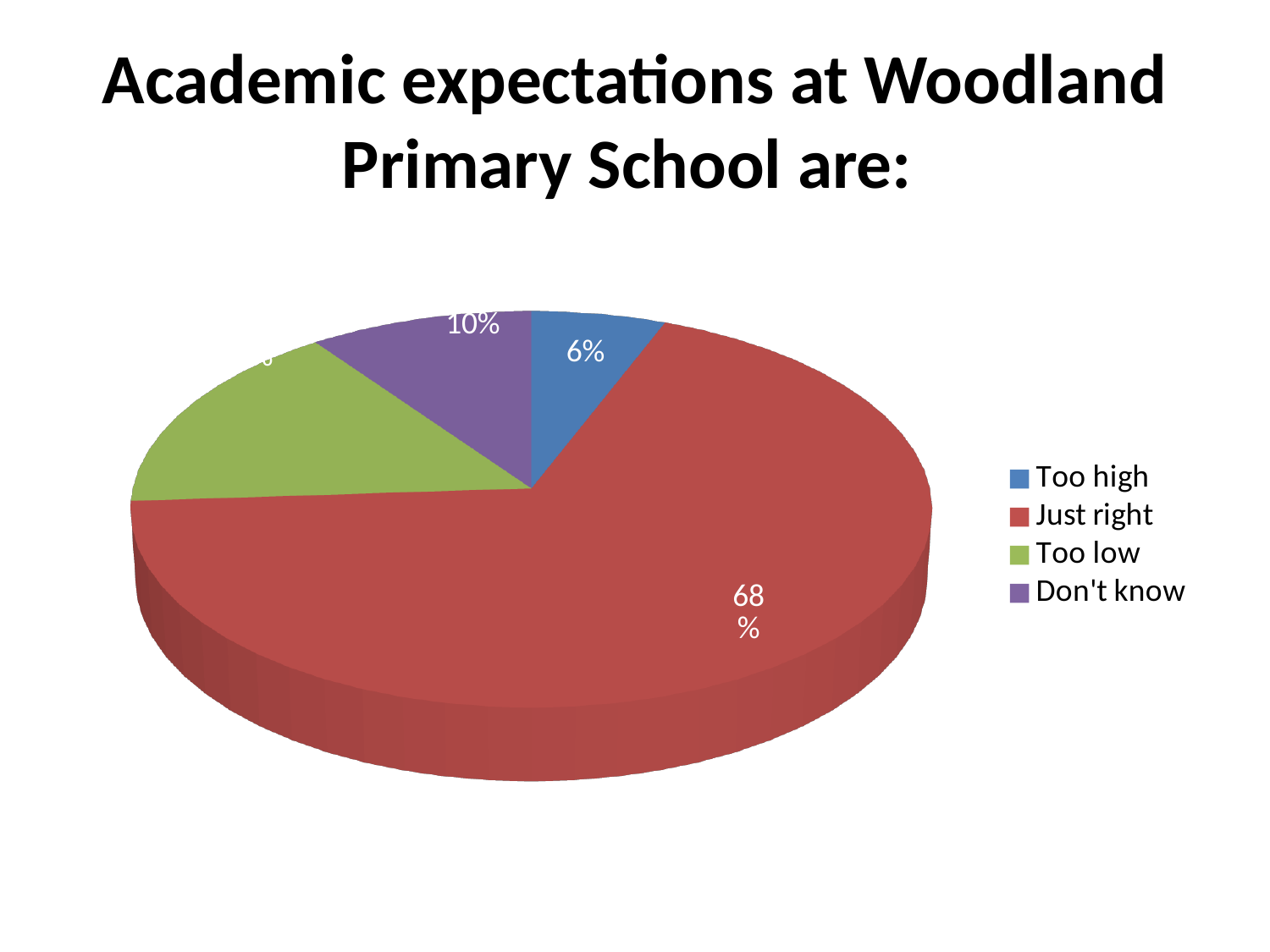
What percentage of respondents said academic expectations are 'Just right'? 68% Which colour represents 'Too low' in the legend? Green What percentage of respondents answered 'Don't know'? 10% What percentage of respondents said academic expectations are 'Too high'? 6% Which is larger, the share for 'Just right' or the share for 'Don't know'? Just right What is the difference in percentage points between 'Just right' and 'Too high'? 62% How many response categories does the pie chart show? 4 Which response has the smallest share of the pie? Too high What kind of chart is shown on the slide? Pie chart What is the difference in percentage points between 'Don't know' and 'Too high'? 4% Which response has the largest share of the pie? Just right Which is larger, the share for 'Don't know' or the share for 'Too high'? Don't know